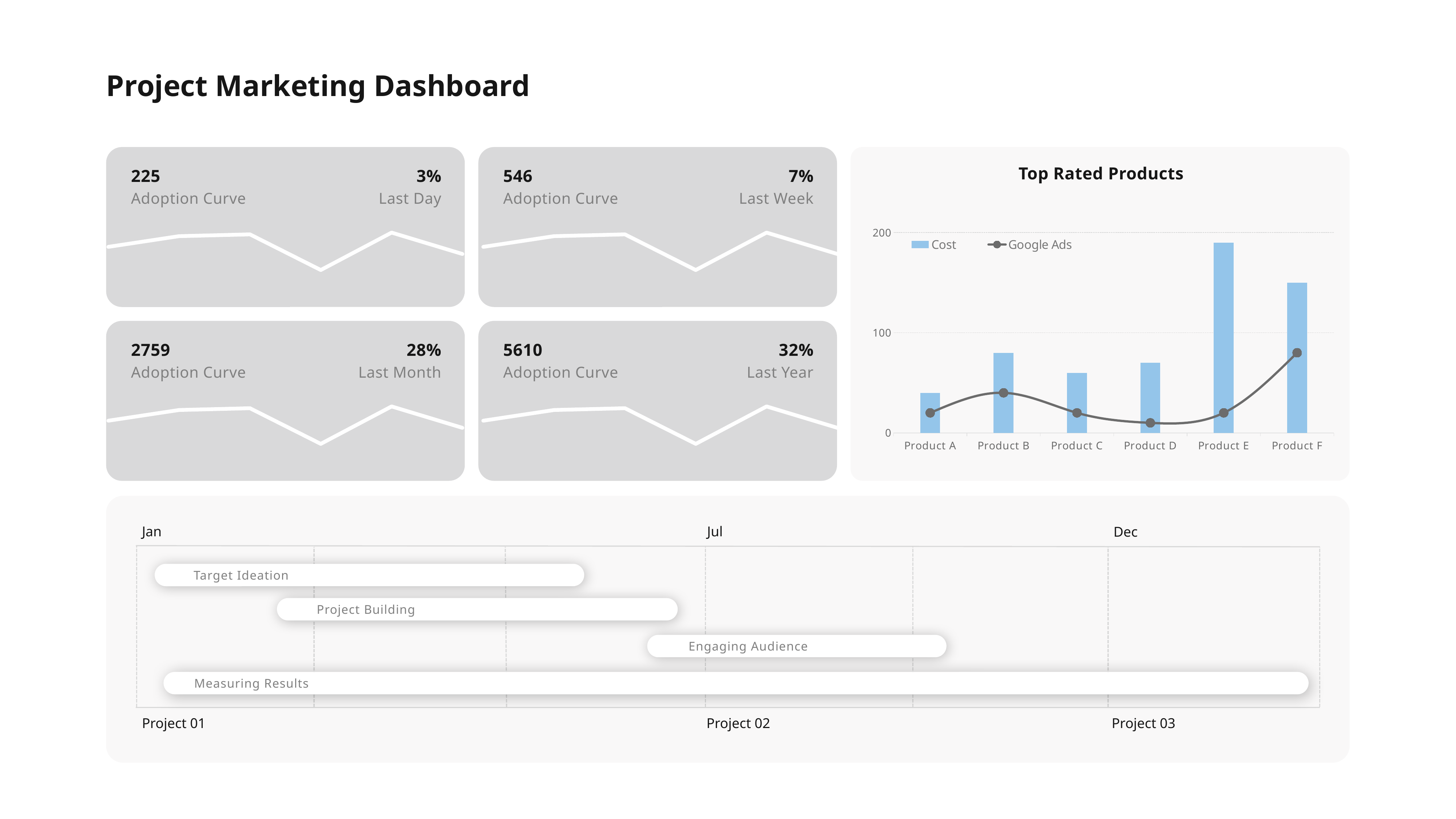
How many products are shown on the x axis of the Top Rated Products chart? 6 Which series in the Top Rated Products chart is drawn as a line? Google Ads In the Top Rated Products chart, is the Cost value for Product B greater or less than 100? less In the Top Rated Products chart, is the Cost value for Product F greater or less than 100? greater How many series does the legend of the Top Rated Products chart list? 2 In the Top Rated Products chart, which product has the highest Google Ads value? Product F What kind of chart is the Top Rated Products chart? Combined bar and line chart In the Top Rated Products chart, is the Cost value for Product A greater or less than 100? less In the Top Rated Products chart, which product has the lowest Cost bar? Product A In the Top Rated Products chart, which product has the highest Cost bar? Product E In the Top Rated Products chart, which has the larger Cost value, Product E or Product F? Product E